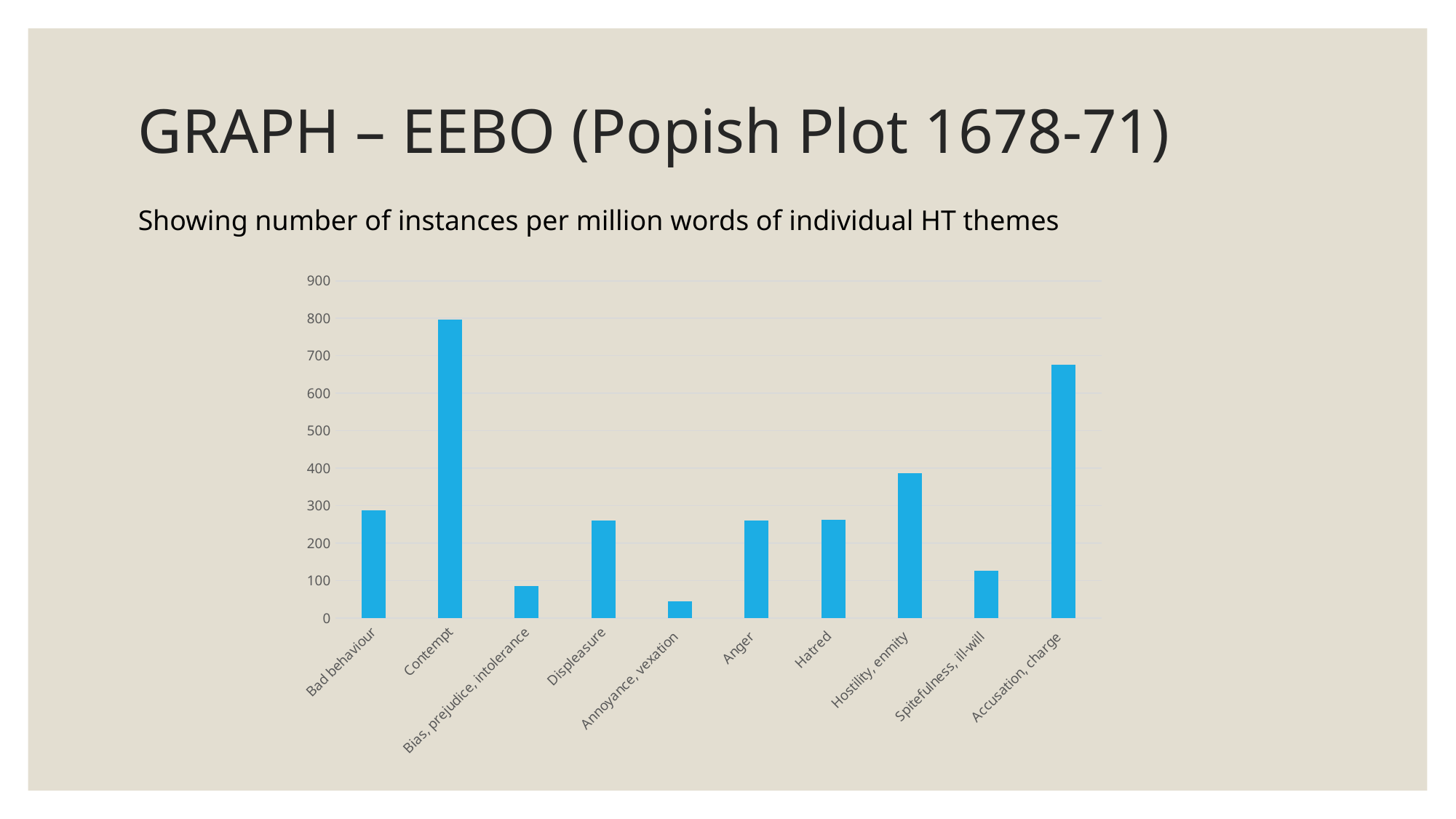
Is the value for Accusation, charge greater or less than 600? greater What is the title of the slide containing the chart? GRAPH – EEBO (Popish Plot 1678-71) Is the value for Spitefulness, ill-will greater or less than 200? less Which is larger, the value for Contempt or the value for Accusation, charge? Contempt How many categories are plotted on the chart? 10 Is the value for Hostility, enmity greater or less than 300? greater Which category has the lowest value? Annoyance, vexation Which category has the highest value? Contempt Which is larger, the value for Hostility, enmity or the value for Bad behaviour? Hostility, enmity What kind of chart is shown on the slide? bar chart